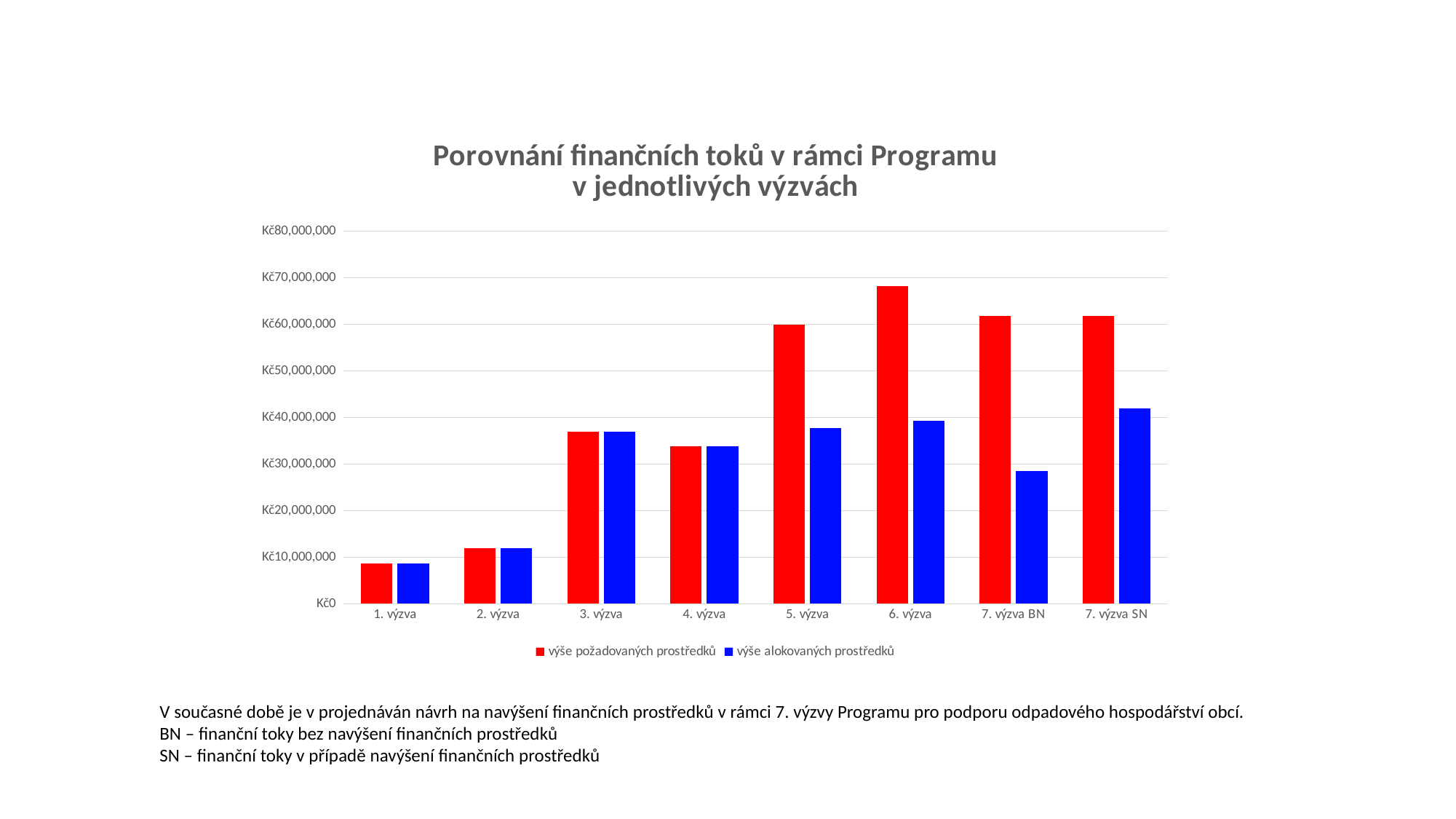
Which category has the lowest value for výše požadovaných prostředků? 1. výzva Which is larger: výše požadovaných prostředků for 5. výzva or for 6. výzva? 6. výzva What kind of chart is shown on the slide? bar chart Is the value of výše požadovaných prostředků for 6. výzva greater or less than Kč60,000,000? greater Is the value of výše alokovaných prostředků for 3. výzva greater or less than Kč30,000,000? greater Which category has the lowest value for výše alokovaných prostředků? 1. výzva Is the value of výše alokovaných prostředků for 7. výzva BN greater or less than Kč40,000,000? less Which is larger: výše alokovaných prostředků for 7. výzva SN or for 7. výzva BN? 7. výzva SN Which category has the highest value for výše požadovaných prostředků? 6. výzva How many series does the legend list? 2 How many categories (výzvy) are shown on the x axis? 8 Which colour represents výše alokovaných prostředků in the chart? blue